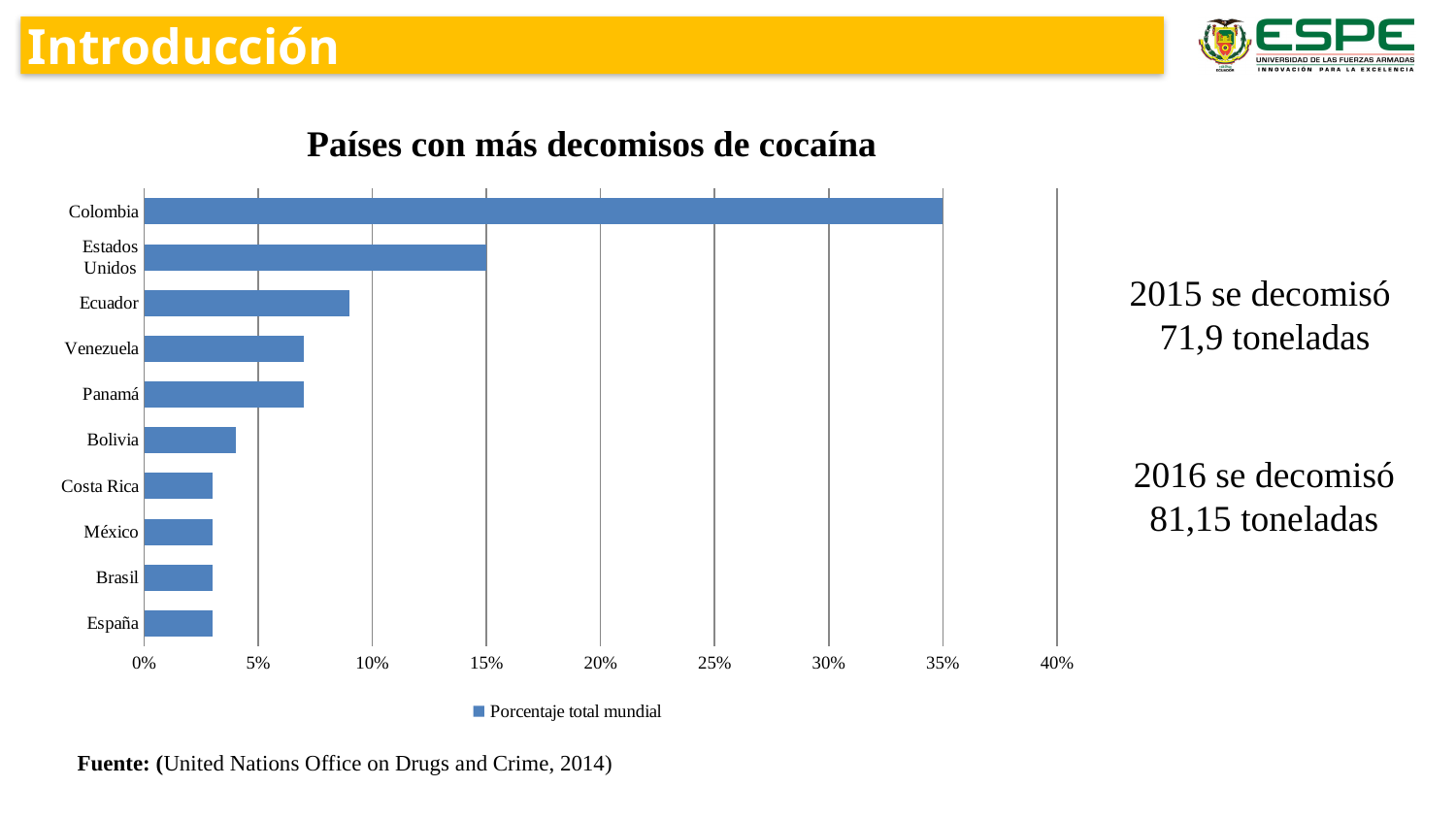
Is the value for Ecuador greater or less than 10%? less Is the value for Bolivia greater or less than 5%? less What is the legend entry of the chart? Porcentaje total mundial What is the value for Colombia? 35% What is the title of the chart? Países con más decomisos de cocaína Is the value for Venezuela greater or less than 5%? greater How many series does the legend list? 1 Which country has the highest percentage in the chart? Colombia Which has a larger value, Ecuador or Venezuela? Ecuador What type of chart is shown on the slide? Bar chart How many countries are shown in the chart? 10 What is the value for Estados Unidos? 15%